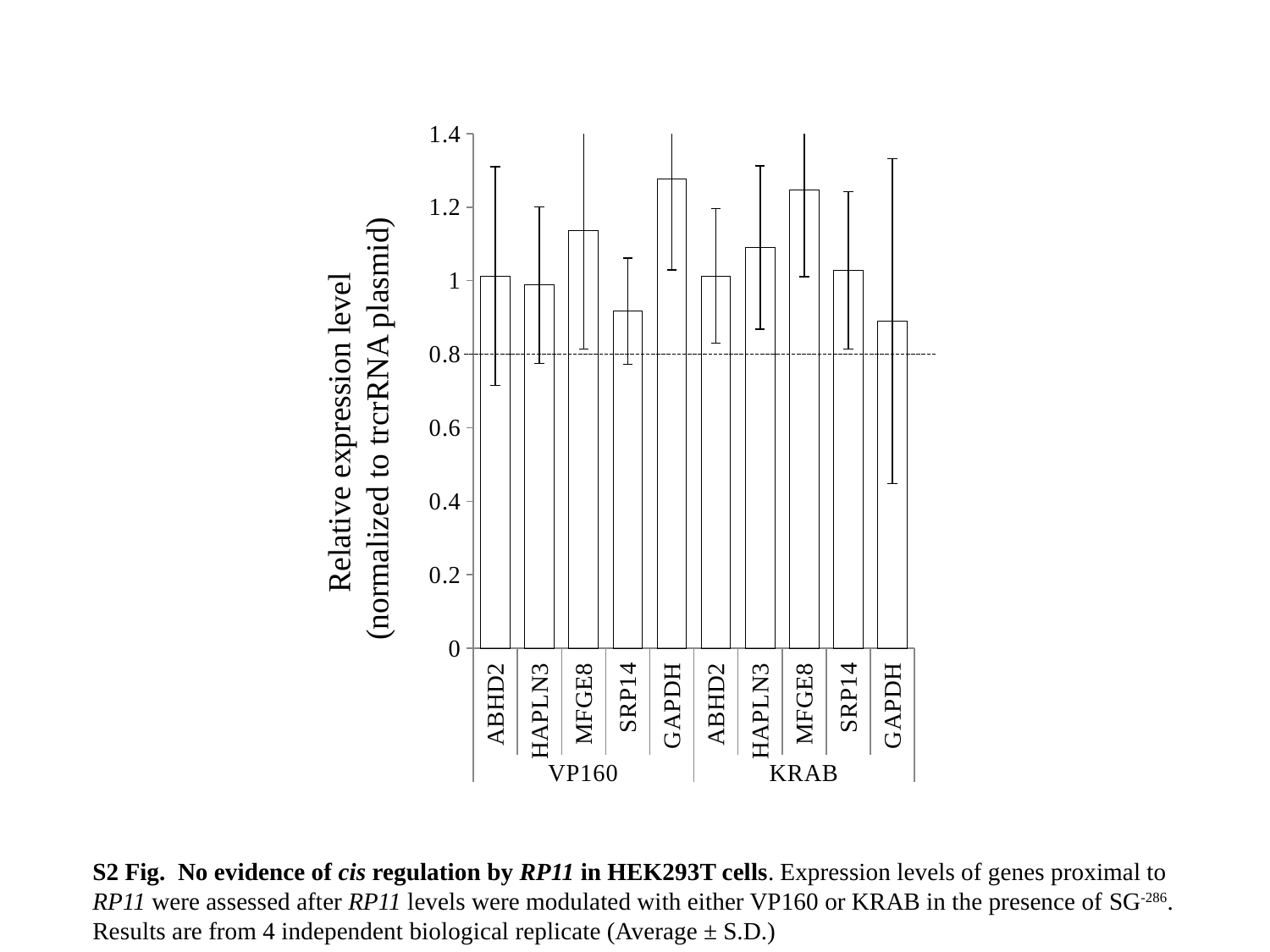
What kind of chart is shown on the slide? bar chart Is the value for GAPDH in the VP160 group greater or less than 1.2? greater Which gene has the highest relative expression level in the KRAB group? MFGE8 How many bars are plotted in the chart? 10 Is the value for GAPDH in the KRAB group greater or less than 1? less Which gene has the lowest relative expression level in the KRAB group? GAPDH Is the value for SRP14 in the VP160 group greater or less than 1? less Which gene has the lowest relative expression level in the VP160 group? SRP14 How many genes are shown within each treatment group (VP160 and KRAB)? 5 Which gene has the highest relative expression level in the VP160 group? GAPDH Which is larger: the value for MFGE8 in the VP160 group or the value for SRP14 in the VP160 group? MFGE8 in the VP160 group At what y-axis value is the horizontal dashed reference line drawn? 0.8